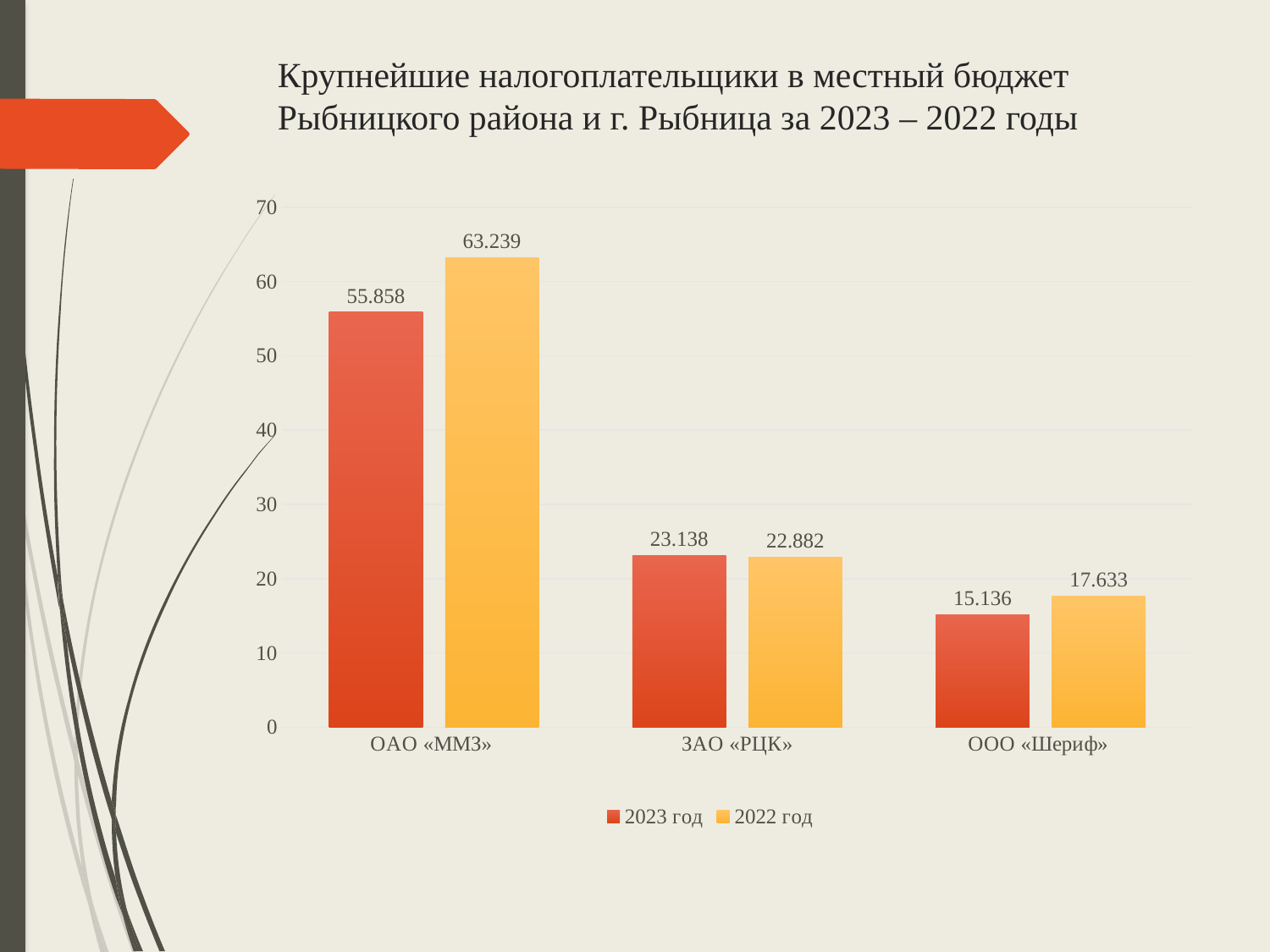
How many categories are shown on the x axis? 3 Which category has the lowest value in the 2023 год series? ООО «Шериф» What is the difference between the 2022 год and 2023 год values for ООО «Шериф»? 2.497 What is the difference between the 2022 год and 2023 год values for ОАО «ММЗ»? 7.381 What is the value for ЗАО «РЦК» in the 2023 год series? 23.138 What is the value for ОАО «ММЗ» in the 2023 год series? 55.858 How many series does the legend list? 2 Which category has the highest value in the 2022 год series? ОАО «ММЗ» What is the value for ООО «Шериф» in the 2022 год series? 17.633 What kind of chart is shown on the slide? Bar chart What is the value for ОАО «ММЗ» in the 2022 год series? 63.239 For ООО «Шериф», which series has the larger value, 2023 год or 2022 год? 2022 год